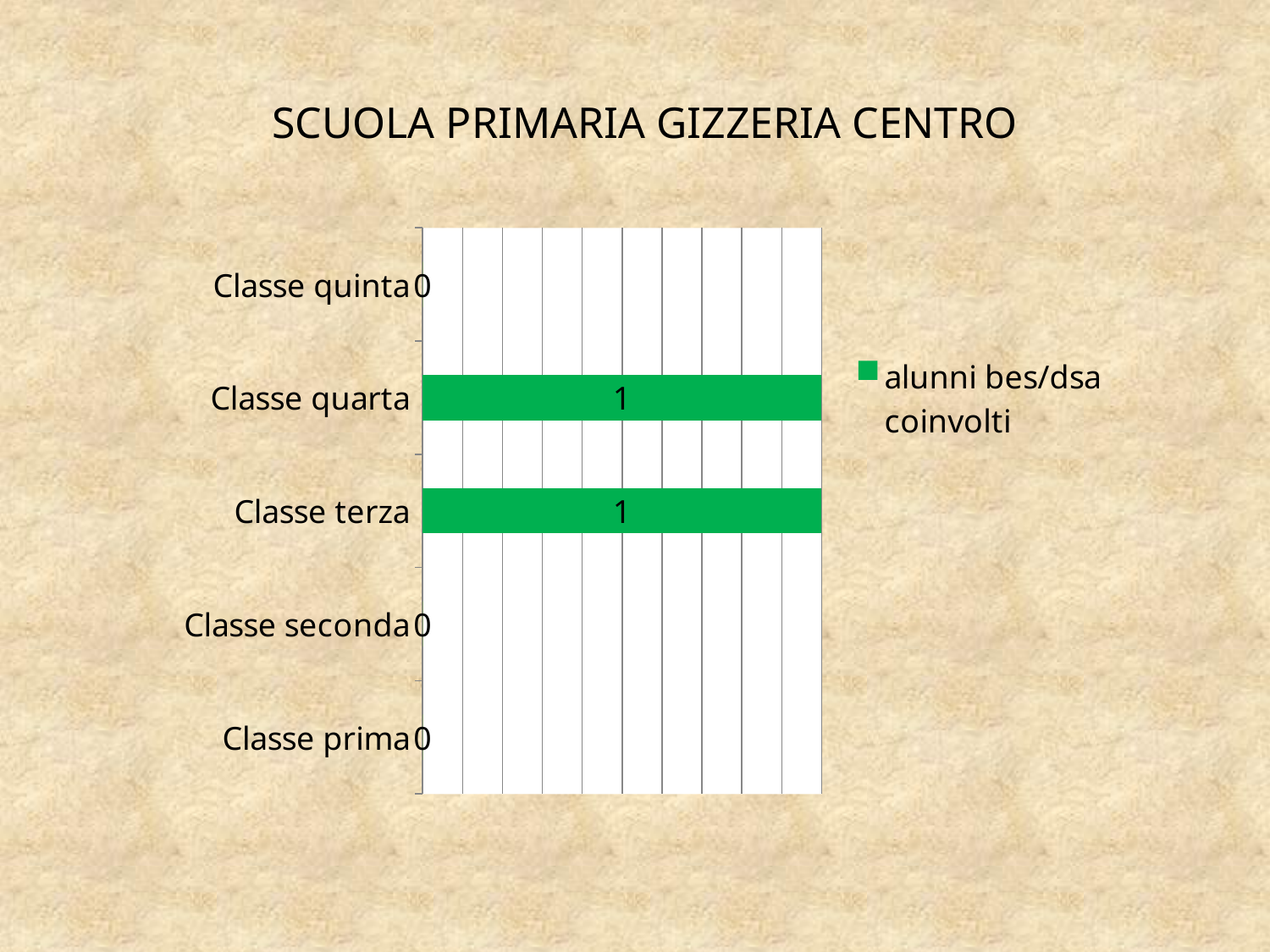
What is the value for Classe quinta? 0 How many series does the legend list? 1 What is the difference between the value for Classe quarta and the value for Classe seconda? 1 What is the title of the slide? SCUOLA PRIMARIA GIZZERIA CENTRO What is the value for Classe quarta? 1 What is the value for Classe prima? 0 What is the value for Classe seconda? 0 Which is larger, the value for Classe quarta or the value for Classe quinta? Classe quarta Which is larger, the value for Classe terza or the value for Classe prima? Classe terza How many categories are shown on the chart? 5 What is the value for Classe terza? 1 What kind of chart is shown on the slide? bar chart